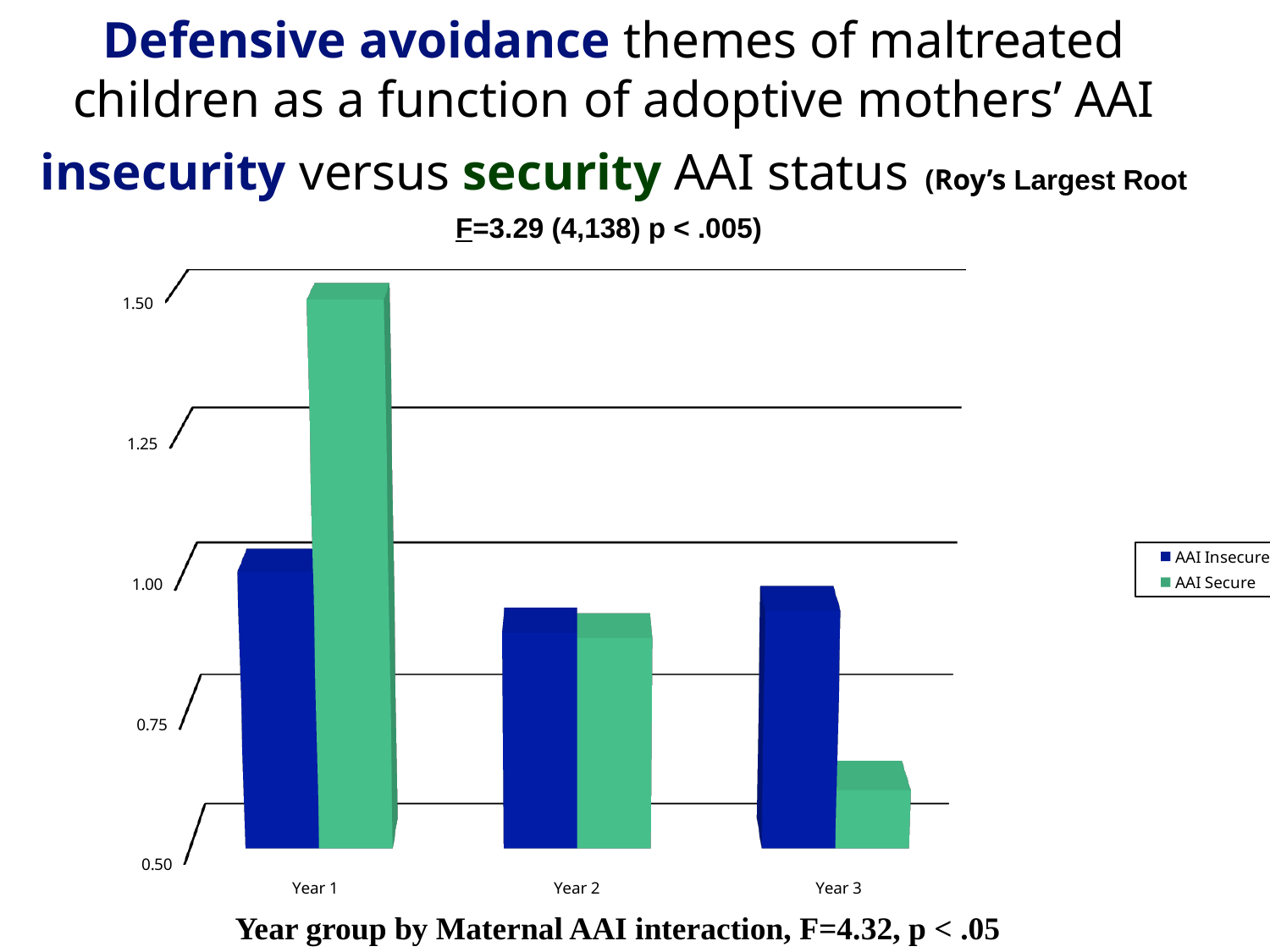
In Year 3, which series has the larger value, AAI Insecure or AAI Secure? AAI Insecure What are the two series named in the chart's legend? AAI Insecure and AAI Secure In Year 1, which series has the larger value, AAI Insecure or AAI Secure? AAI Secure How many year groups are shown on the x axis of the chart? 3 Which year group has the highest AAI Secure bar? Year 1 What kind of chart is shown on the slide? Bar chart Which colour represents the AAI Secure series in the chart? Green Is the AAI Secure value for Year 1 greater or less than 1.25? greater How many series does the chart's legend list? 2 Which year group has the lowest AAI Secure bar? Year 3 Do the AAI Secure values rise or fall from Year 1 to Year 3? Fall Is the AAI Secure value for Year 3 greater or less than 0.75? less